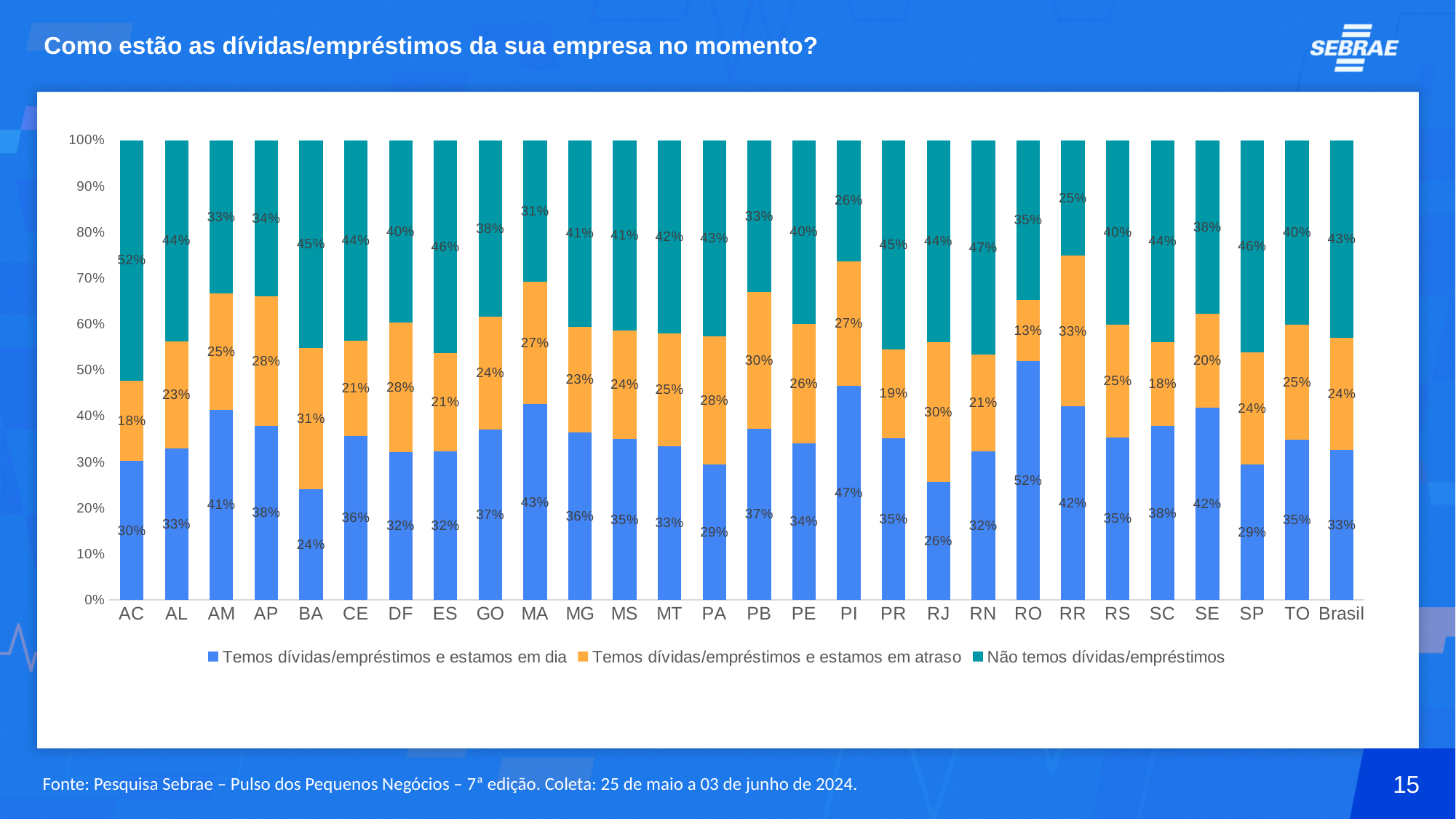
What kind of chart is shown on the slide? Stacked bar chart Which state has the highest value in the series 'Temos dívidas/empréstimos e estamos em dia'? RO What is the value for RR in the series 'Temos dívidas/empréstimos e estamos em atraso'? 33% What is the difference between the 'Não temos dívidas/empréstimos' values for AC and RR? 27% Which is larger in the series 'Temos dívidas/empréstimos e estamos em dia': PI or MA? PI How many series does the legend list? 3 What is the title of the slide? Como estão as dívidas/empréstimos da sua empresa no momento? Which state has the lowest value in the series 'Temos dívidas/empréstimos e estamos em dia'? BA What is the value for Brasil in the series 'Temos dívidas/empréstimos e estamos em dia'? 33% Which state has the lowest value in the series 'Temos dívidas/empréstimos e estamos em atraso'? RO What is the value for AC in the series 'Não temos dívidas/empréstimos'? 52% How many categories are shown on the x axis? 28